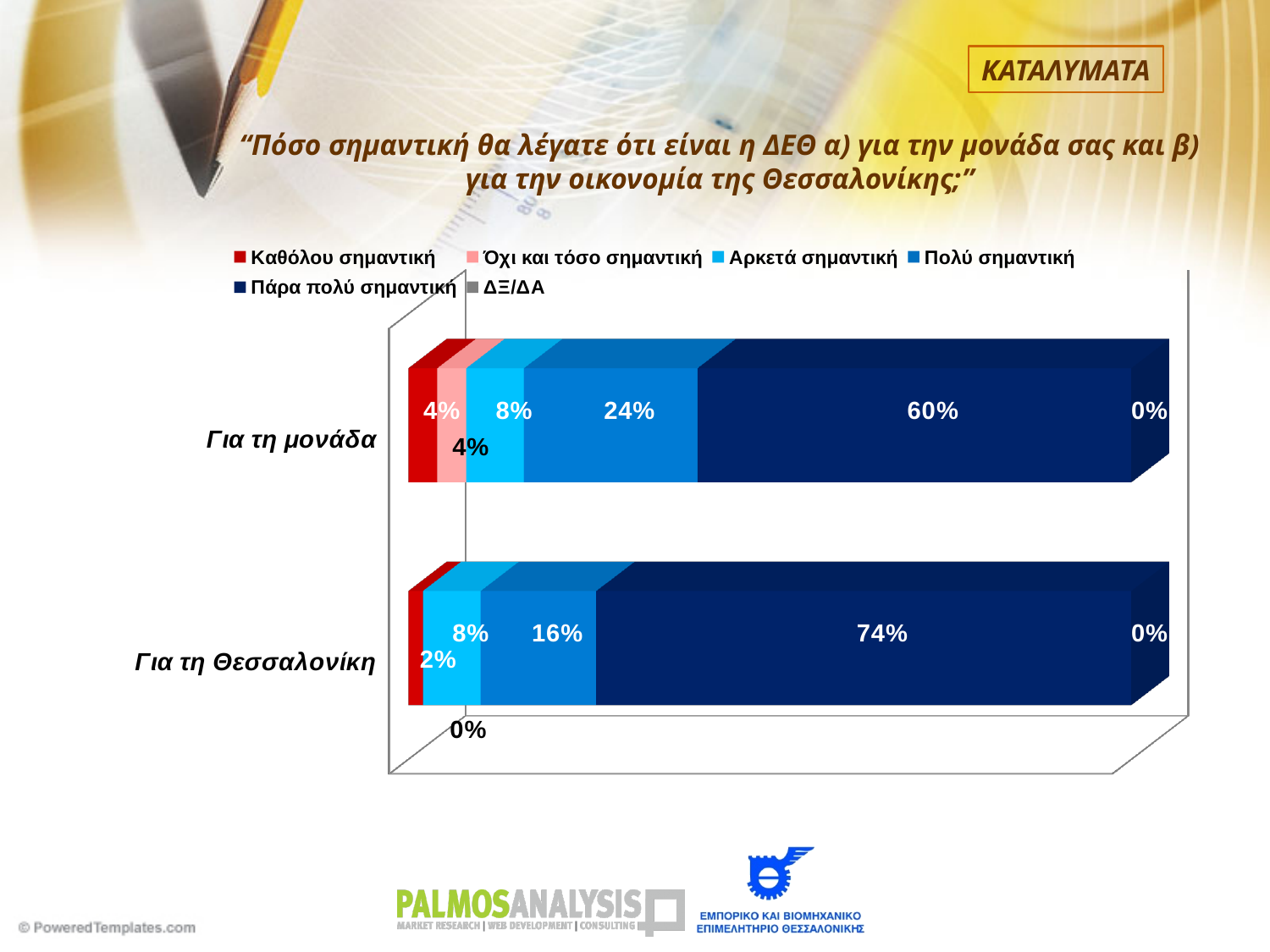
What is the value of "Πάρα πολύ σημαντική" for "Για τη Θεσσαλονίκη"? 74% What is the value of "Πάρα πολύ σημαντική" for "Για τη μονάδα"? 60% How many series does the legend list? 6 What is the difference between the "Πάρα πολύ σημαντική" values for "Για τη Θεσσαλονίκη" and "Για τη μονάδα"? 14% What kind of chart is shown on the slide? Stacked bar chart What is the value of "Πολύ σημαντική" for "Για τη μονάδα"? 24% What is the total of the stacked bar for "Για τη μονάδα"? 100% Which series is shown in red in the legend? Καθόλου σημαντική What is the value of "Καθόλου σημαντική" for "Για τη Θεσσαλονίκη"? 2% What is the value of "Όχι και τόσο σημαντική" for "Για τη Θεσσαλονίκη"? 0% How many categories are plotted on the chart? 2 Which category has the larger "Πολύ σημαντική" value, "Για τη μονάδα" or "Για τη Θεσσαλονίκη"? Για τη μονάδα